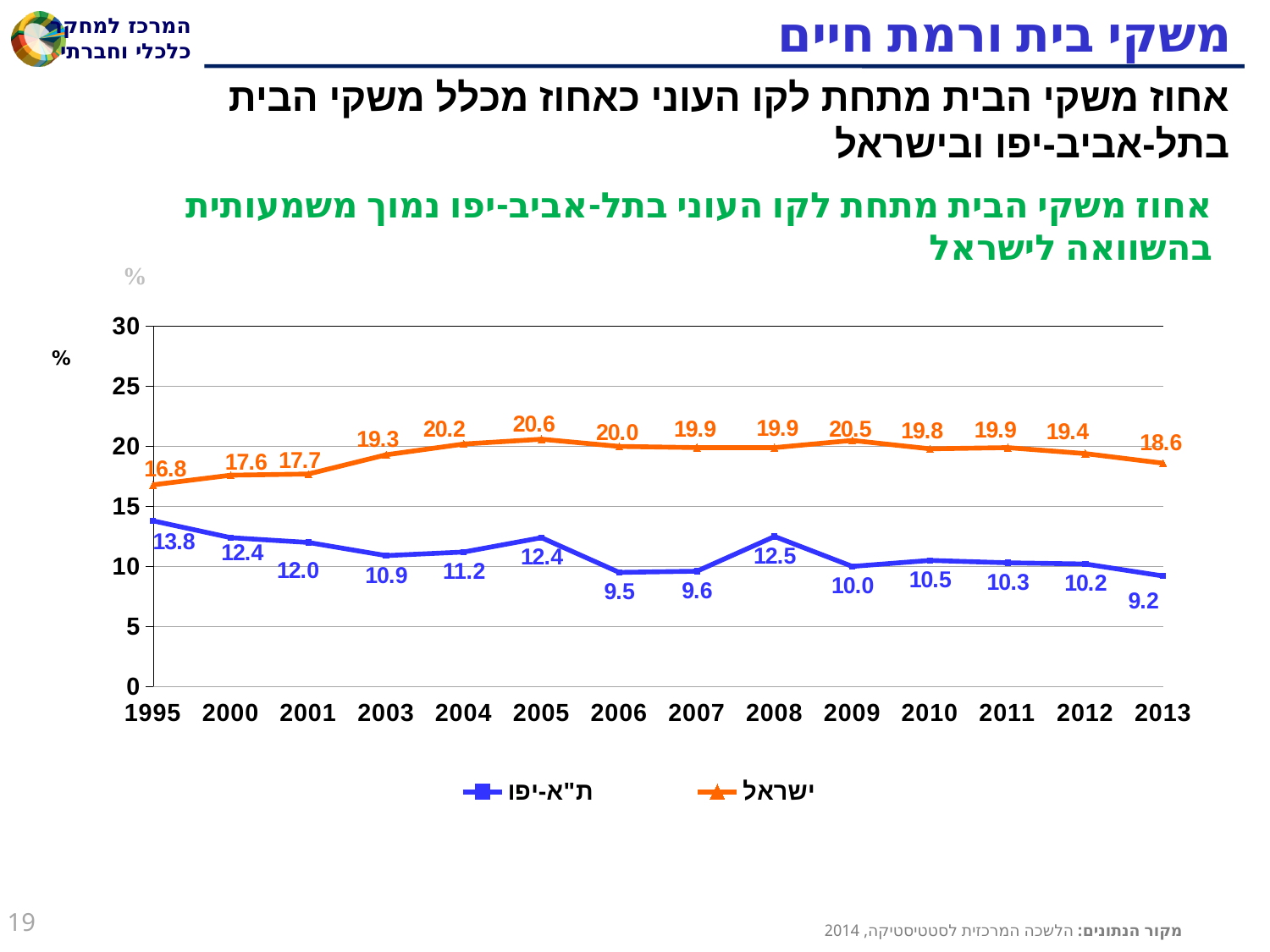
What is the difference between the ישראל and ת"א-יפו values in 2013? 9.4 In which year is the ישראל series at its highest? 2005 In which year is the ת"א-יפו series at its lowest? 2013 How many years are shown on the x axis? 14 In which year is the ת"א-יפו series at its highest? 1995 Does the ת"א-יפו series rise or fall from 1995 to 2013 overall? Fall What is the value for ת"א-יפו in 2013? 9.2 What kind of chart is shown on the slide? Line chart Which series has the larger value in 2009, ישראל or ת"א-יפו? ישראל What is the value for ישראל in 2005? 20.6 How many series does the legend list? 2 What is the value for ת"א-יפו in 2008? 12.5